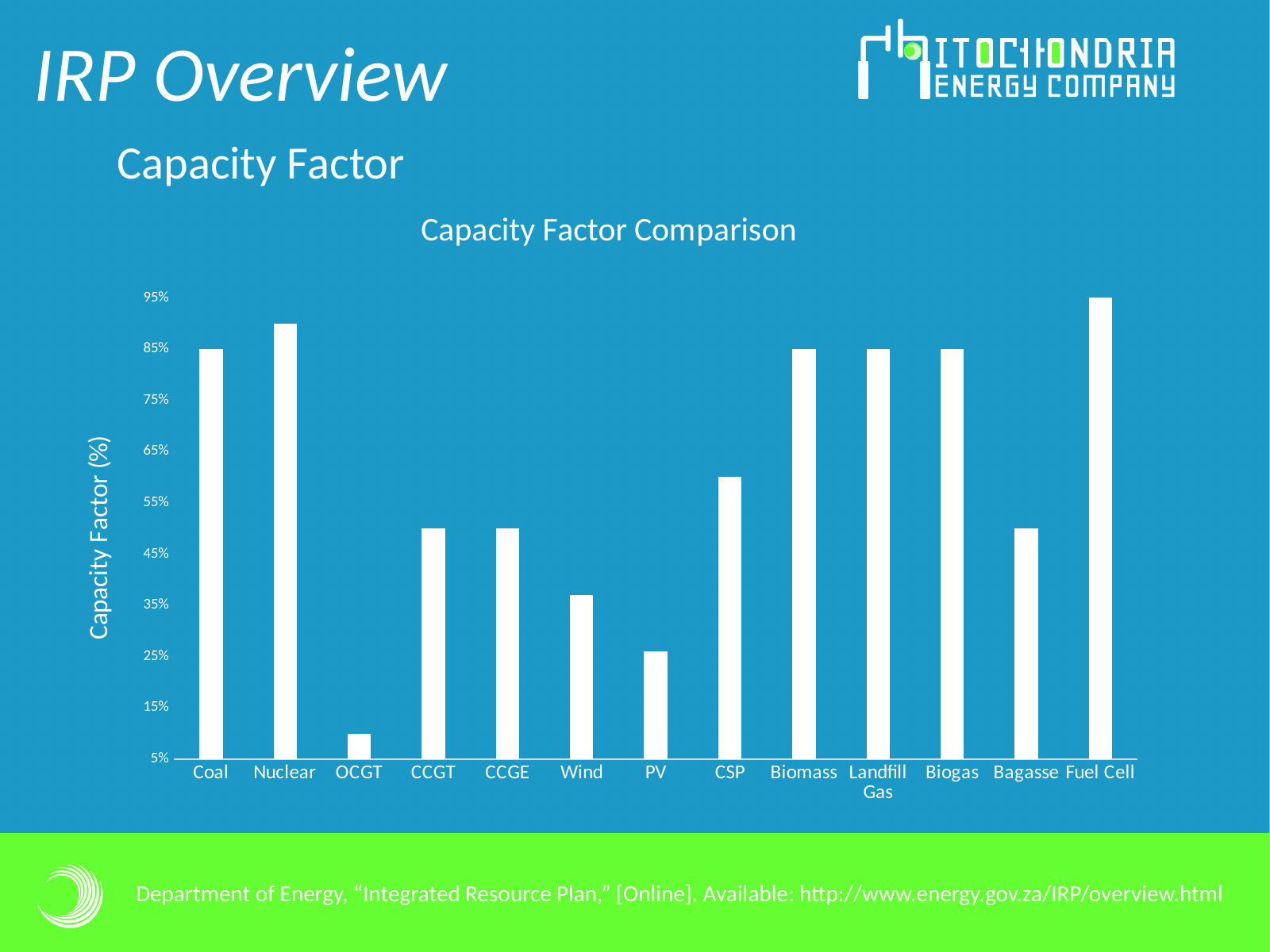
What is the capacity factor for Fuel Cell? 95% How many categories are plotted on the x axis of the chart? 13 What type of chart is shown on the slide? bar chart Which category has the lowest capacity factor in the chart? OCGT Is the value for OCGT greater or less than 15%? less What is the label on the y axis of the chart? Capacity Factor (%) Is the value for CSP greater or less than 55%? greater Which category has the highest capacity factor in the chart? Fuel Cell Which has a larger capacity factor, CSP or Wind? CSP What is the capacity factor for Coal? 85% Is the value for Nuclear greater or less than 85%? greater What is the title of the chart? Capacity Factor Comparison